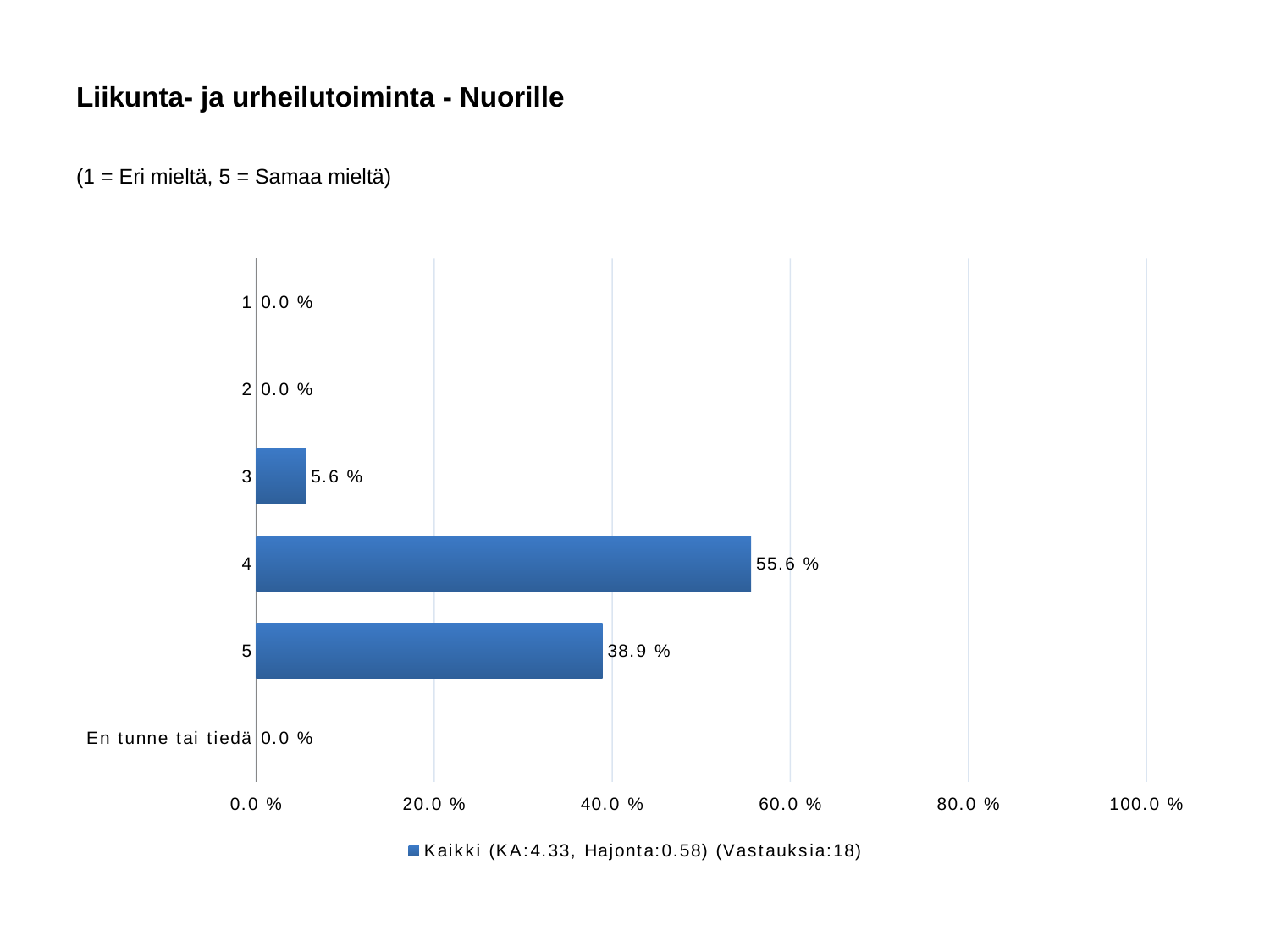
What kind of chart is shown on the slide? bar chart Is the value for category 4 greater or less than 40.0 %? greater How many categories are shown on the chart? 6 Which category has the highest value? 4 What is the value for category 4? 55.6 % How many series does the legend list? 1 What is the value for 'En tunne tai tiedä'? 0.0 % What is the difference between the values for category 4 and category 5? 16.7 % Which is larger, the value for category 3 or the value for category 5? 5 What is the value for category 5? 38.9 % What is the value for category 3? 5.6 % What is the title of the chart? Liikunta- ja urheilutoiminta - Nuorille